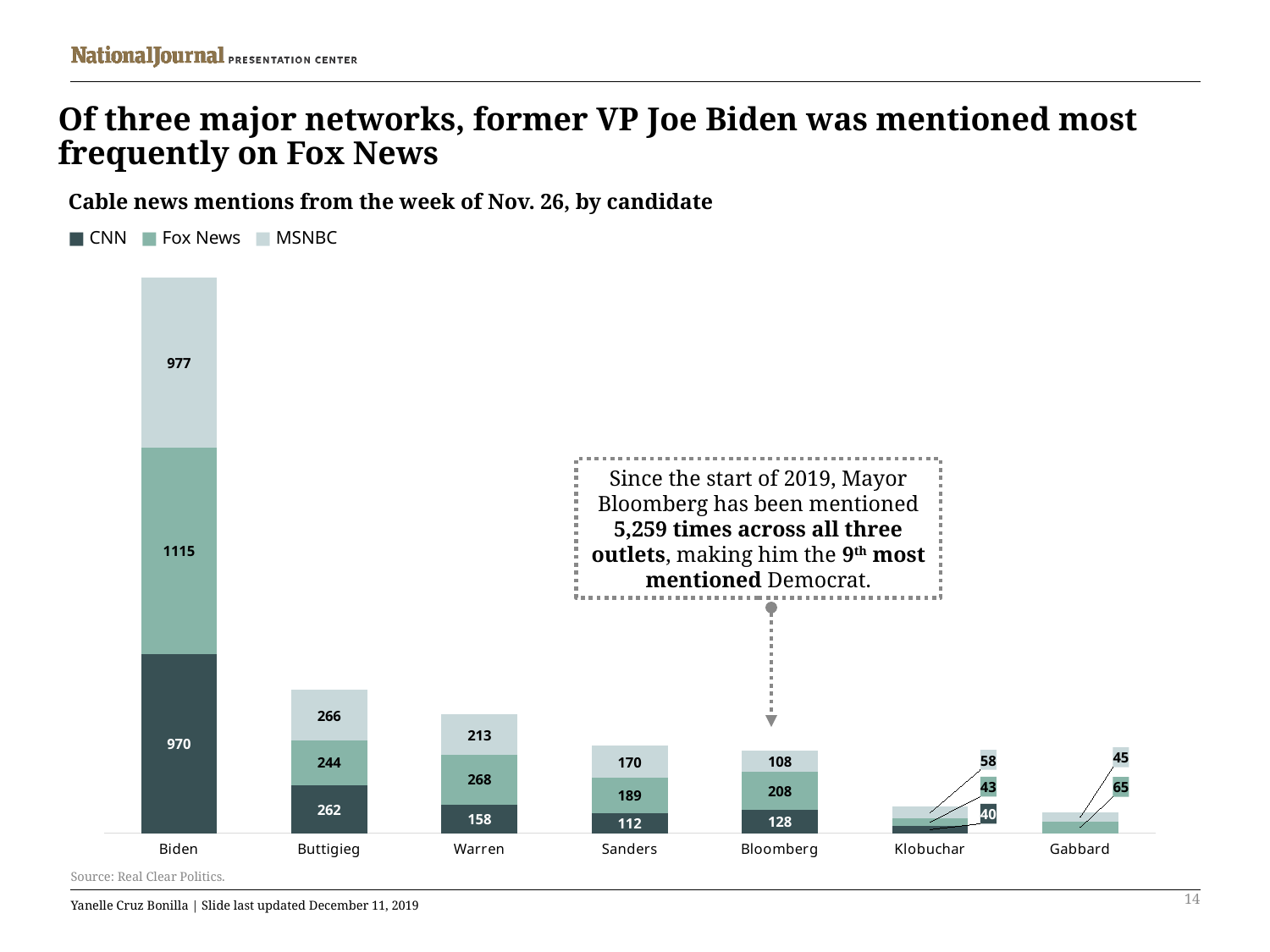
How many MSNBC mentions did Sanders receive? 170 How many CNN mentions did Warren receive? 158 What is the total number of mentions across all three networks for Buttigieg? 772 How many Fox News mentions did Bloomberg receive? 208 Who received more Fox News mentions, Warren or Buttigieg? Warren Which candidate has the tallest bar overall? Biden What source is cited for the chart data? Real Clear Politics How many series does the legend list? 3 What kind of chart is shown on the slide? Stacked bar chart What is the difference between Biden's Fox News mentions and his CNN mentions? 145 How many candidates are shown on the x axis? 7 How many Fox News mentions did Biden receive? 1115